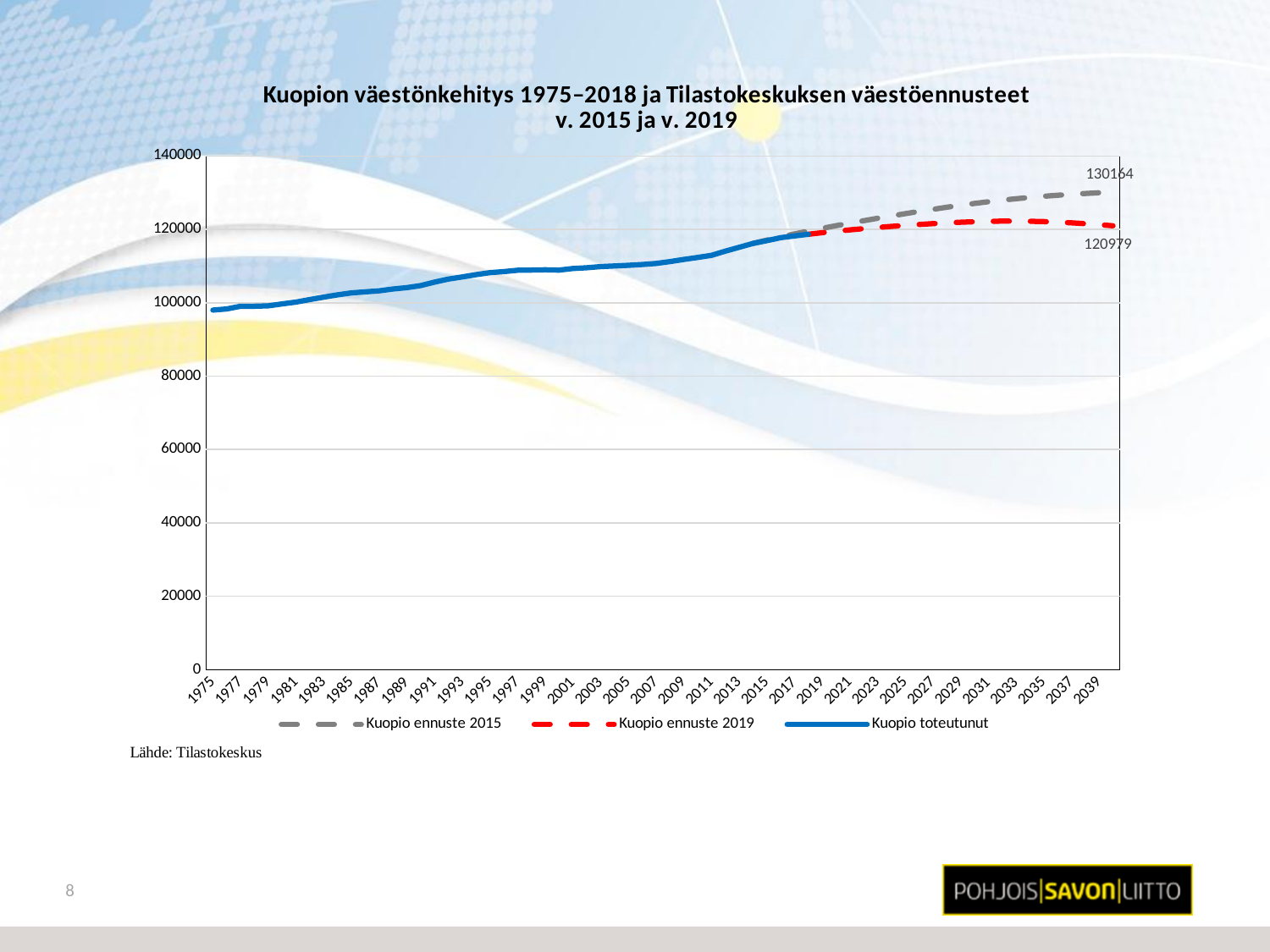
What is the final labelled value of the Kuopio ennuste 2019 series? 120979 Is the value for Kuopio toteutunut in 1975 greater or less than 120000? less Does the Kuopio toteutunut series rise or fall from 1975 to 2018? rises Does the Kuopio ennuste 2015 series rise or fall over the forecast period? rises What is the final labelled value of the Kuopio ennuste 2015 series? 130164 What kind of chart is shown on the slide? line chart What colour is the Kuopio toteutunut line? blue What is the title of the chart? Kuopion väestönkehitys 1975–2018 ja Tilastokeskuksen väestöennusteet v. 2015 ja v. 2019 Is the value for Kuopio toteutunut in 2017 greater or less than 110000? greater How many series does the legend list? 3 Which forecast series ends at a higher value, Kuopio ennuste 2015 or Kuopio ennuste 2019? Kuopio ennuste 2015 What is the difference between the final labelled values of Kuopio ennuste 2015 and Kuopio ennuste 2019? 9185